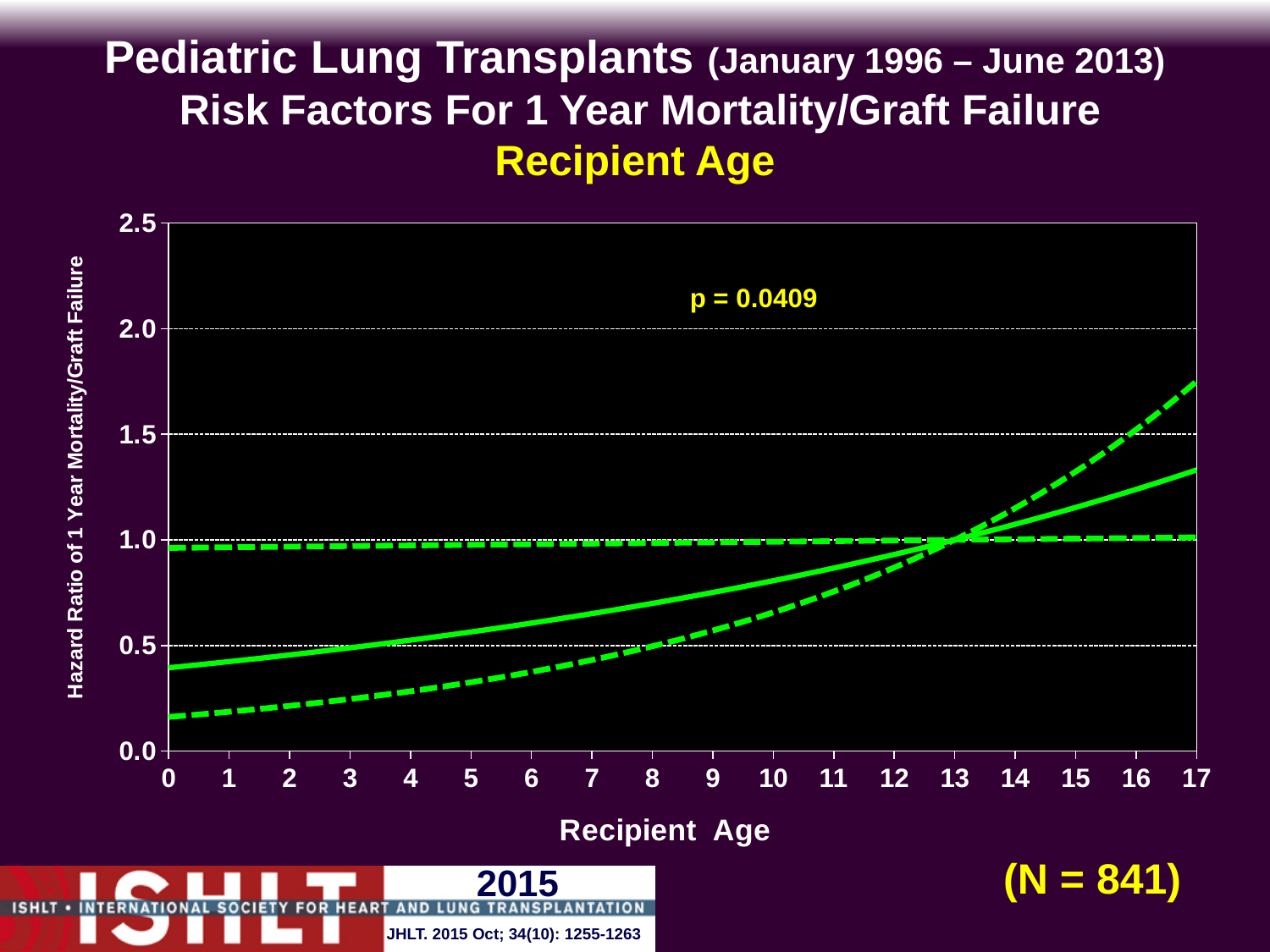
Is the solid hazard ratio line higher at recipient age 17 or at recipient age 0? age 17 What kind of chart is shown on the slide? line chart How many lines are plotted on the chart? 3 Is the value of the solid hazard ratio line at recipient age 17 greater or less than 1.0? greater Is the value of the solid hazard ratio line at recipient age 5 greater or less than 1.0? less Is the value of the lower dashed line at recipient age 0 greater or less than 0.5? less Does the solid hazard ratio line rise or fall as recipient age increases from 0 to 17? rises What p-value is printed on the chart? p = 0.0409 What is the highest value shown on the y axis of the chart? 2.5 What sample size (N) is shown on the slide? N = 841